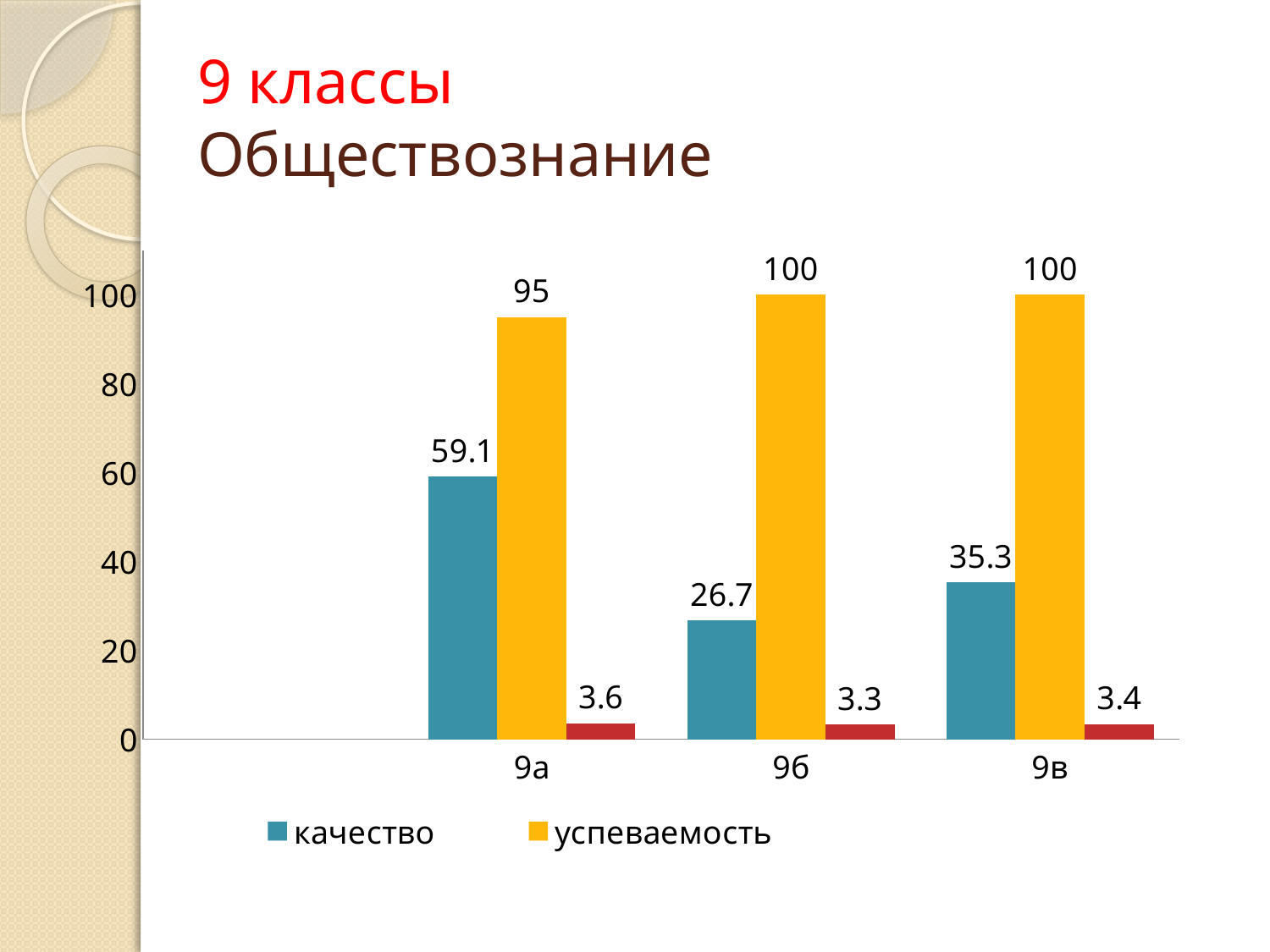
How many classes are shown on the x axis? 3 What is the value of качество for 9а? 59.1 How many series does the legend list? 2 Which is larger: качество for 9в or качество for 9б? качество for 9в What is the value of успеваемость for 9б? 100 What kind of chart is shown on the slide? bar chart What is the value of успеваемость for 9а? 95 What is the value of качество for 9в? 35.3 What is the difference between the качество values for 9а and 9б? 32.4 What is the value of the red bar for 9а? 3.6 Which class has the highest качество value? 9а Which class has the lowest качество value? 9б